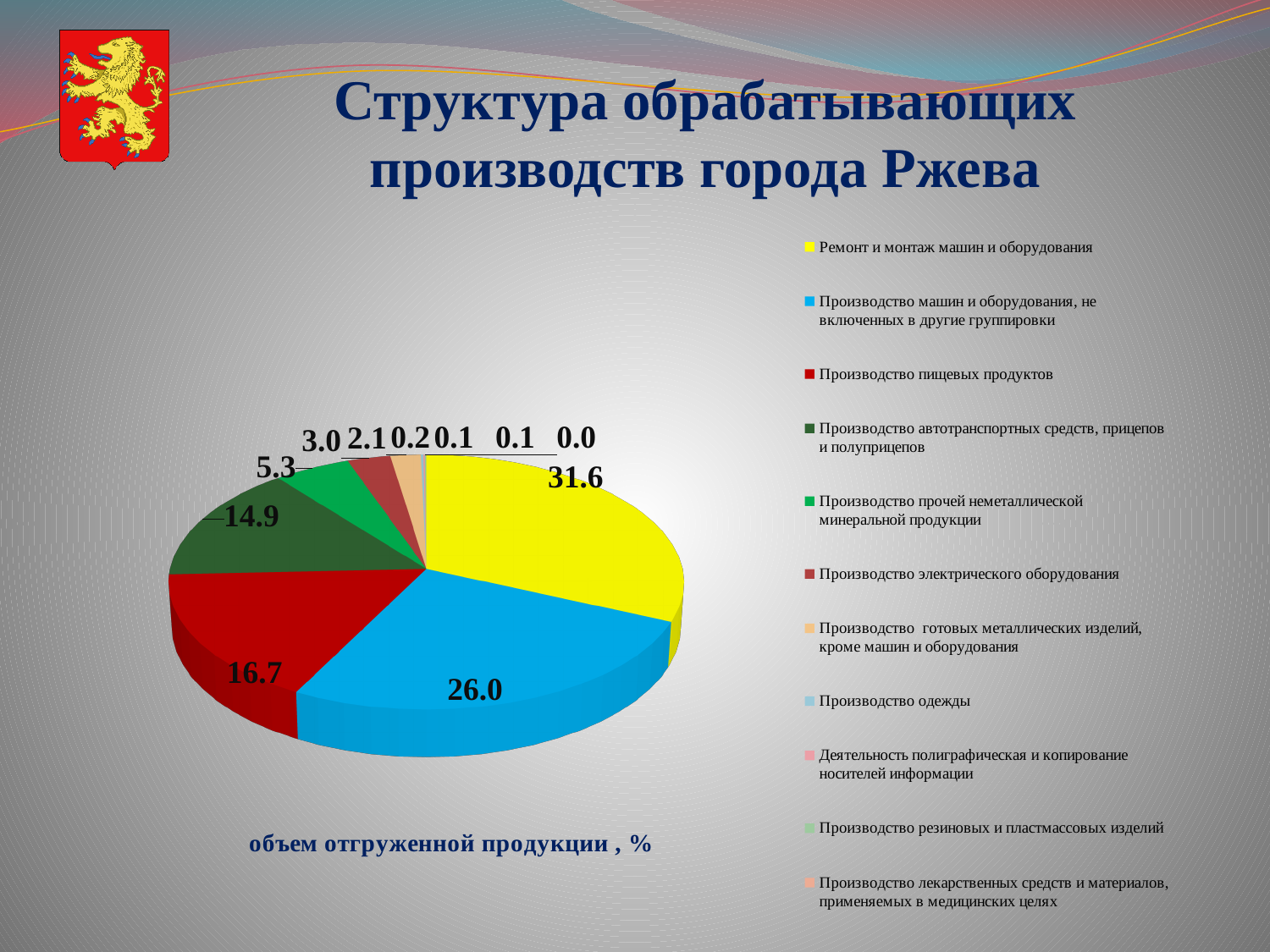
What is the value for "Производство автотранспортных средств, прицепов и полуприцепов"? 14.9 What is the title shown below the pie chart? объем отгруженной продукции , % What is the value for "Ремонт и монтаж машин и оборудования"? 31.6 What is the value for "Производство машин и оборудования, не включенных в другие группировки"? 26.0 Which is larger: the value for "Производство пищевых продуктов" or for "Производство автотранспортных средств, прицепов и полуприцепов"? Производство пищевых продуктов How many categories does the legend list? 11 What is the value for "Производство электрического оборудования"? 3.0 What type of chart is shown on the slide? pie chart Which category has the smallest value in the pie chart? Производство лекарственных средств и материалов, применяемых в медицинских целях Which category has the largest share of the pie? Ремонт и монтаж машин и оборудования What is the value for "Производство пищевых продуктов"? 16.7 What is the difference between the values for "Ремонт и монтаж машин и оборудования" and "Производство машин и оборудования, не включенных в другие группировки"? 5.6